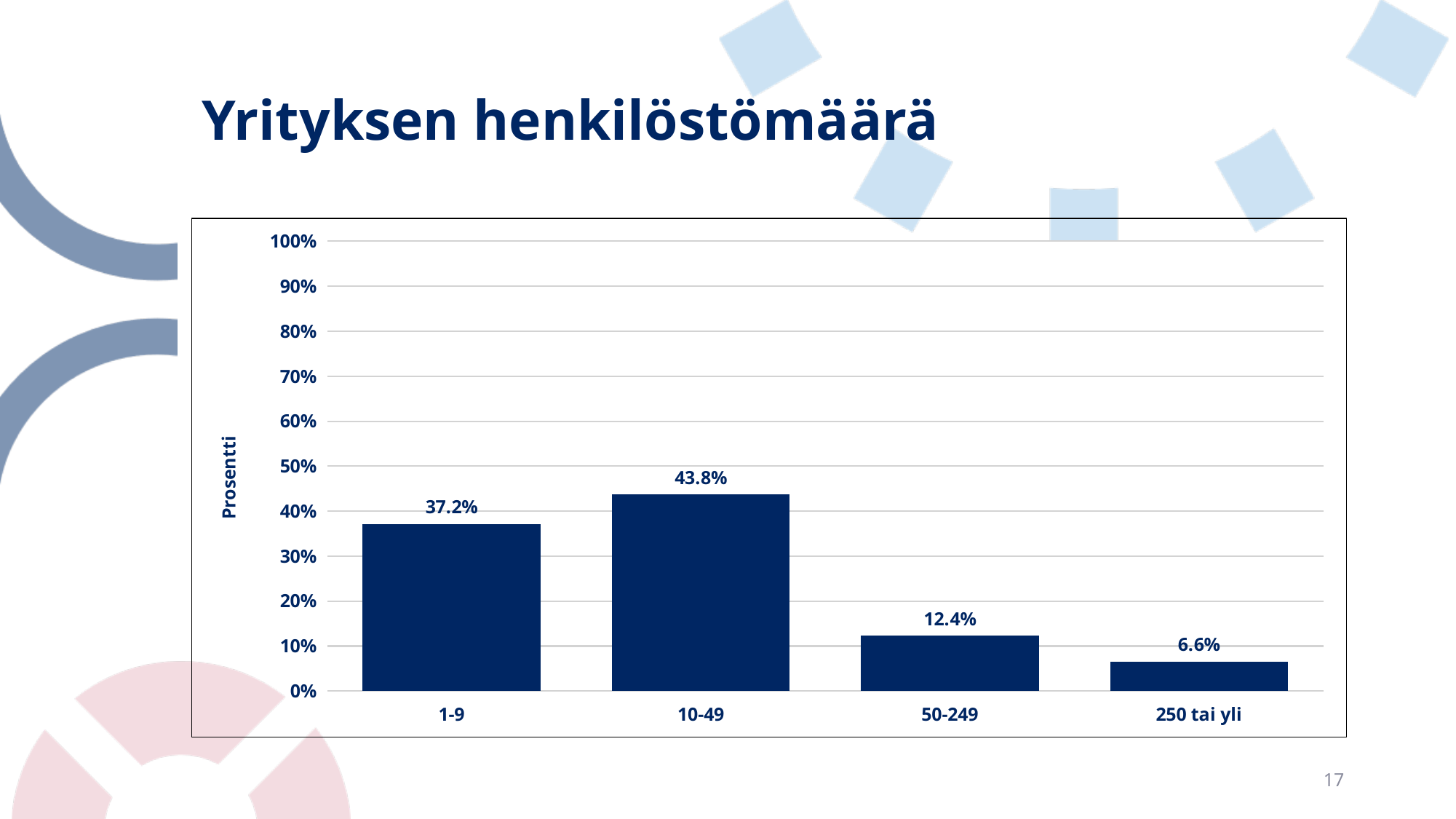
Which category has the highest value? 10-49 Which category has the lowest value? 250 tai yli What is the value for the 50-249 category? 12.4% Which is larger, the value for 50-249 or the value for 250 tai yli? 50-249 What is the value for the 250 tai yli category? 6.6% What kind of chart is shown on the slide? bar chart What is the label of the y axis? Prosentti What is the difference between the values for 10-49 and 1-9? 6.6% How many categories are shown on the x axis? 4 What is the value for the 1-9 category? 37.2% What is the value for the 10-49 category? 43.8% Is the value for 1-9 greater or less than 40%? less